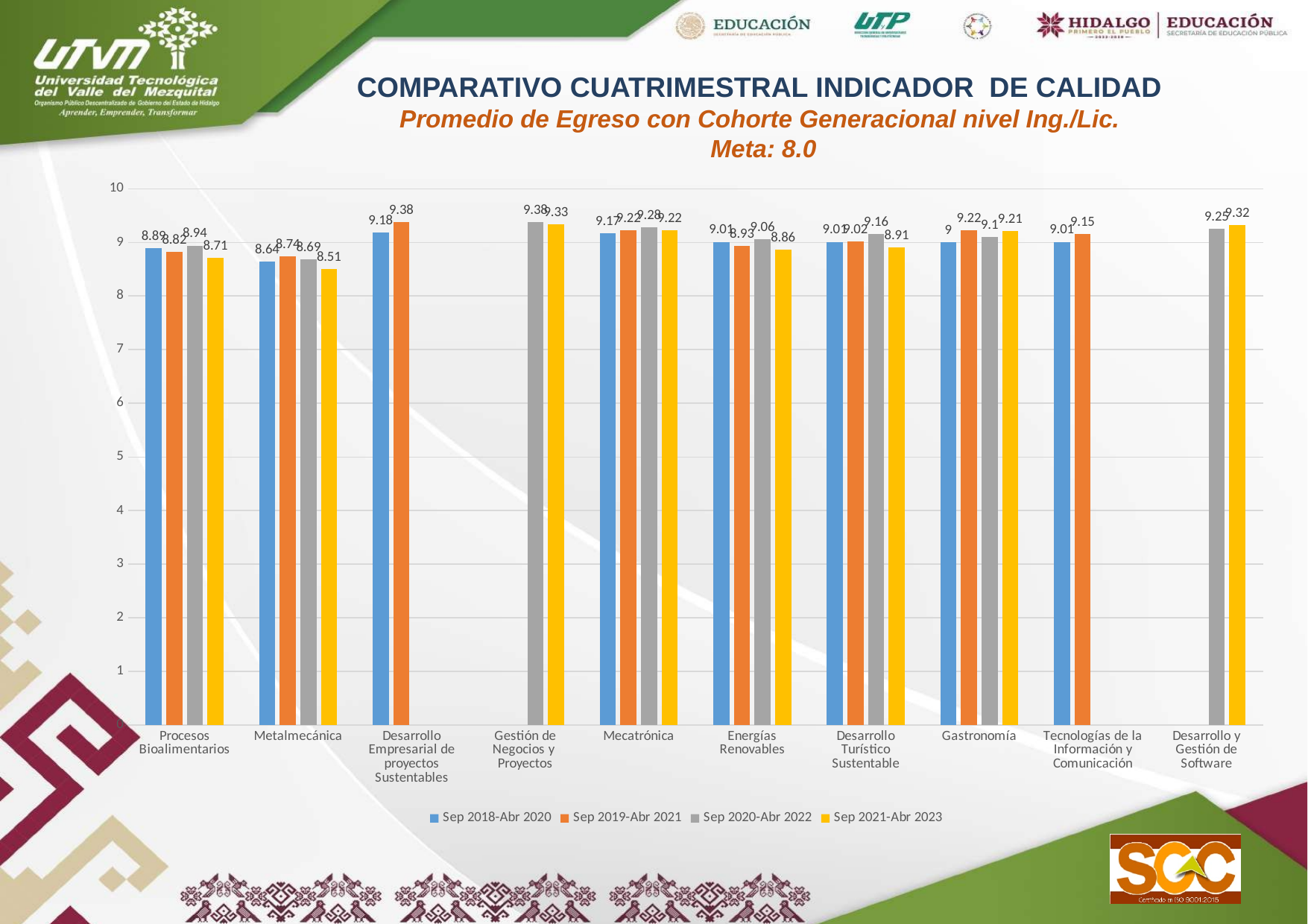
What is the value for Gastronomía in the Sep 2018-Abr 2020 series? 9 What is the value for Desarrollo Empresarial de proyectos Sustentables in the Sep 2019-Abr 2021 series? 9.38 What kind of chart is shown on the slide? bar chart What is the value for Metalmecánica in the Sep 2021-Abr 2023 series? 8.51 What target (Meta) is stated in the chart's subtitle? 8.0 Which program has the lowest value in the Sep 2021-Abr 2023 series? Metalmecánica Is the value for Mecatrónica in the Sep 2018-Abr 2020 series greater or less than 9? greater For Procesos Bioalimentarios, which is larger: the Sep 2020-Abr 2022 value or the Sep 2021-Abr 2023 value? Sep 2020-Abr 2022 For Metalmecánica, which series has the highest value? Sep 2019-Abr 2021 How many series does the legend list? 4 What is the difference between the Sep 2019-Abr 2021 and Sep 2021-Abr 2023 values for Metalmecánica? 0.23 How many programs (categories) are shown on the x axis? 10